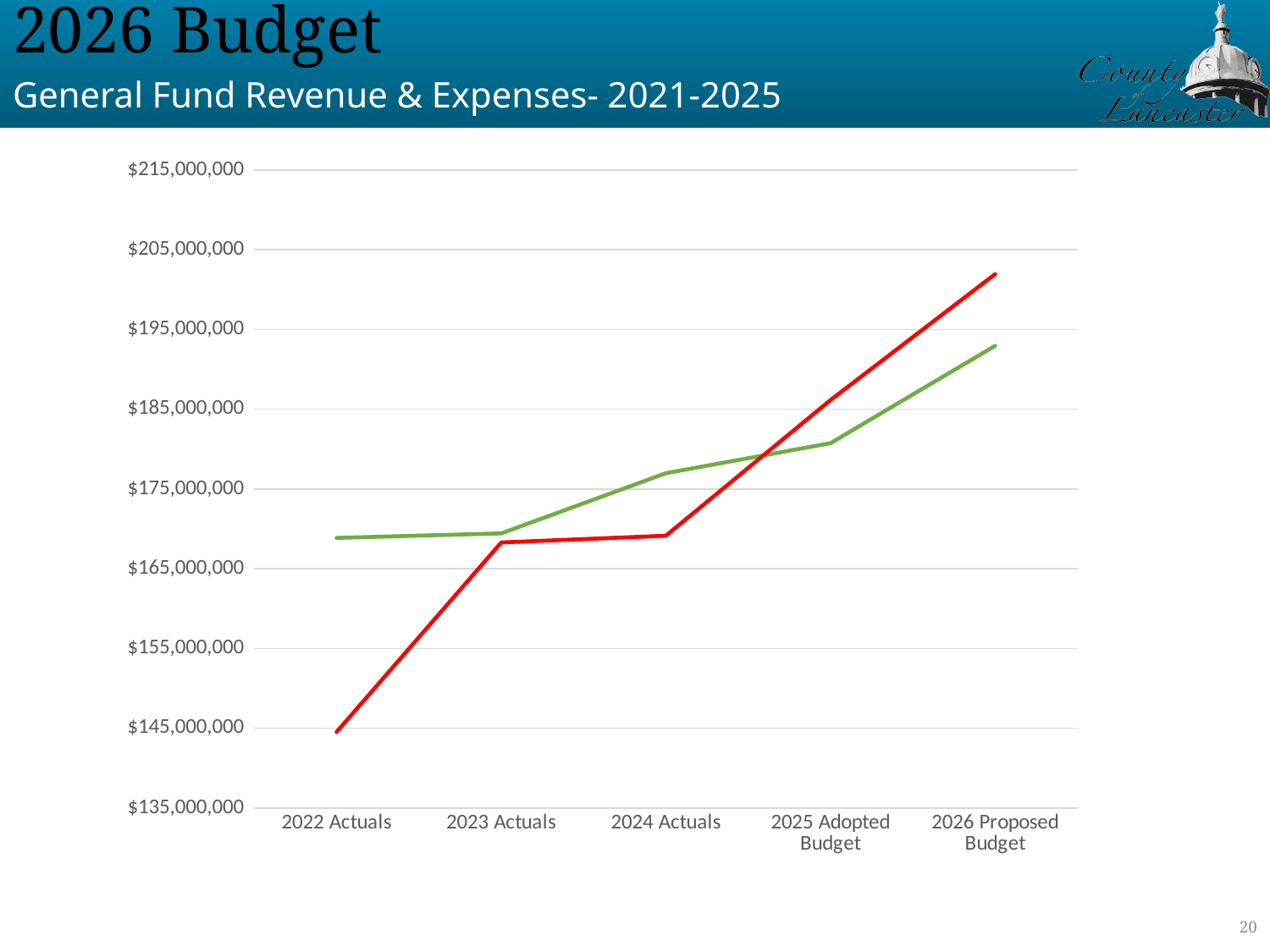
Is the value of the green line for 2022 Actuals greater or less than $165,000,000? greater Is the value of the red line for 2022 Actuals greater or less than $155,000,000? less Is the value of the green line for 2025 Adopted Budget greater or less than $175,000,000? greater At 2022 Actuals, which line has the higher value, the red line or the green line? Green line How many categories are shown along the x axis? 5 How many lines are plotted on the chart? 2 At which category does the red line reach its highest value? 2026 Proposed Budget What kind of chart is shown on the slide? Line chart What is the subtitle of the chart slide? General Fund Revenue & Expenses- 2021-2025 Does the red line generally rise or fall from 2022 Actuals to 2026 Proposed Budget? Rise At 2026 Proposed Budget, which line has the higher value, the red line or the green line? Red line